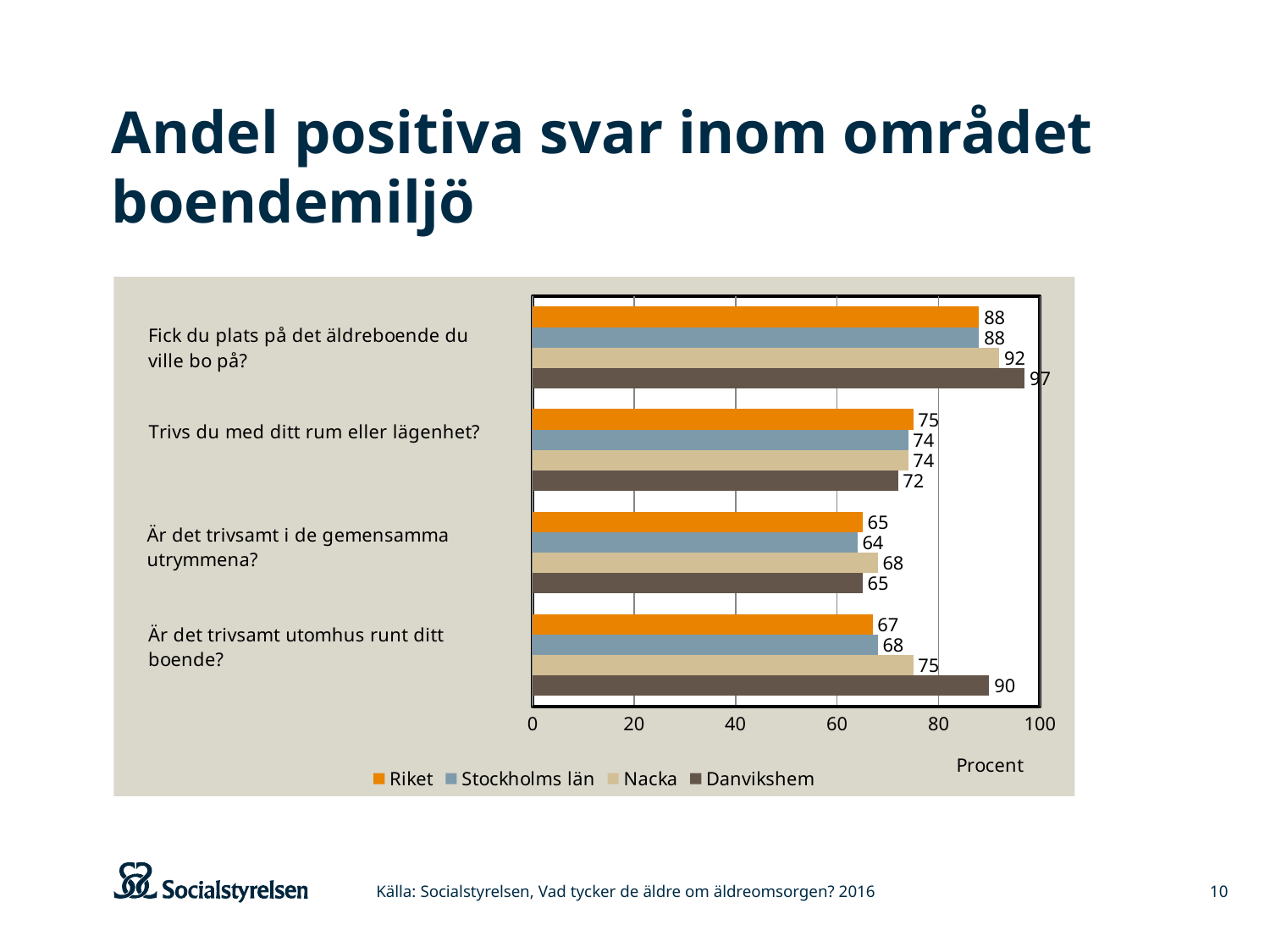
Which series has the highest value on "Fick du plats på det äldreboende du ville bo på?"? Danvikshem How many questions (categories) are shown on the chart? 4 Which series has the lowest value on "Trivs du med ditt rum eller lägenhet?"? Danvikshem What is the value for Danvikshem on "Är det trivsamt utomhus runt ditt boende?"? 90 Which is larger on "Är det trivsamt i de gemensamma utrymmena?": Nacka or Stockholms län? Nacka What is the value for Riket on "Trivs du med ditt rum eller lägenhet?"? 75 Is the value for Danvikshem on "Fick du plats på det äldreboende du ville bo på?" greater or less than 80? greater What kind of chart is shown on the slide? Bar chart What is the value for Nacka on "Fick du plats på det äldreboende du ville bo på?"? 92 What is the value for Stockholms län on "Är det trivsamt i de gemensamma utrymmena?"? 64 How many series does the legend list? 4 What is the difference between Danvikshem and Riket on "Är det trivsamt utomhus runt ditt boende?"? 23